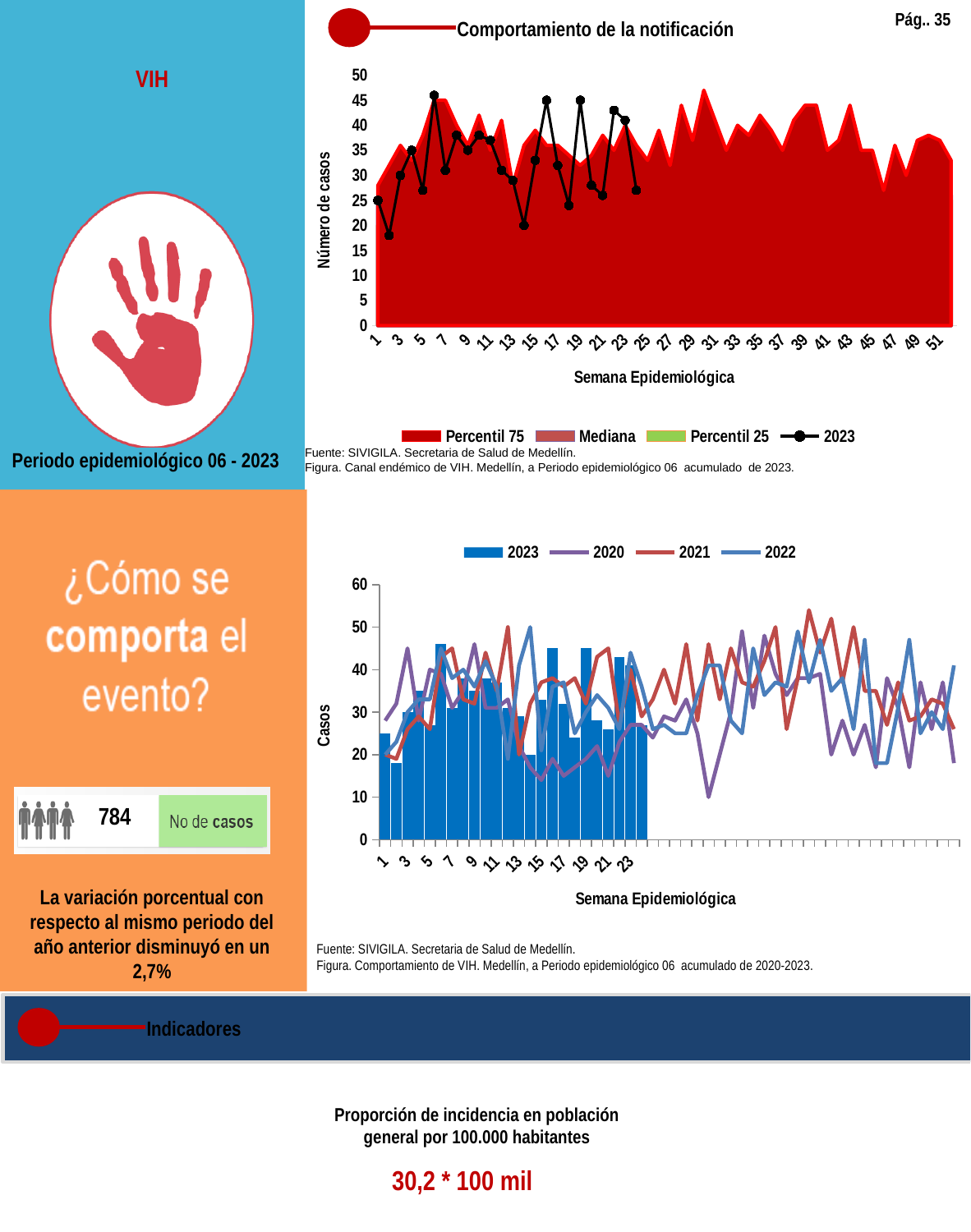
In the bottom chart, which is larger for 2023: the value for week 6 or the value for week 2? week 6 In the bottom chart, is the 2023 value for week 6 greater or less than 40? greater In the top chart 'Comportamiento de la notificación', is the 2023 value for week 2 greater or less than 20? less In the top chart 'Comportamiento de la notificación', what is the label of the y axis? Número de casos In the bottom chart, which is larger for 2023: the value for week 17 or the value for week 19? week 19 In the top chart 'Comportamiento de la notificación', is the 2023 value for week 6 greater or less than 40? greater In the top chart 'Comportamiento de la notificación', which series is drawn as a black line with dot markers? 2023 In the top chart 'Comportamiento de la notificación', how many series does the legend list? 4 In the bottom chart, how many series does the legend list? 4